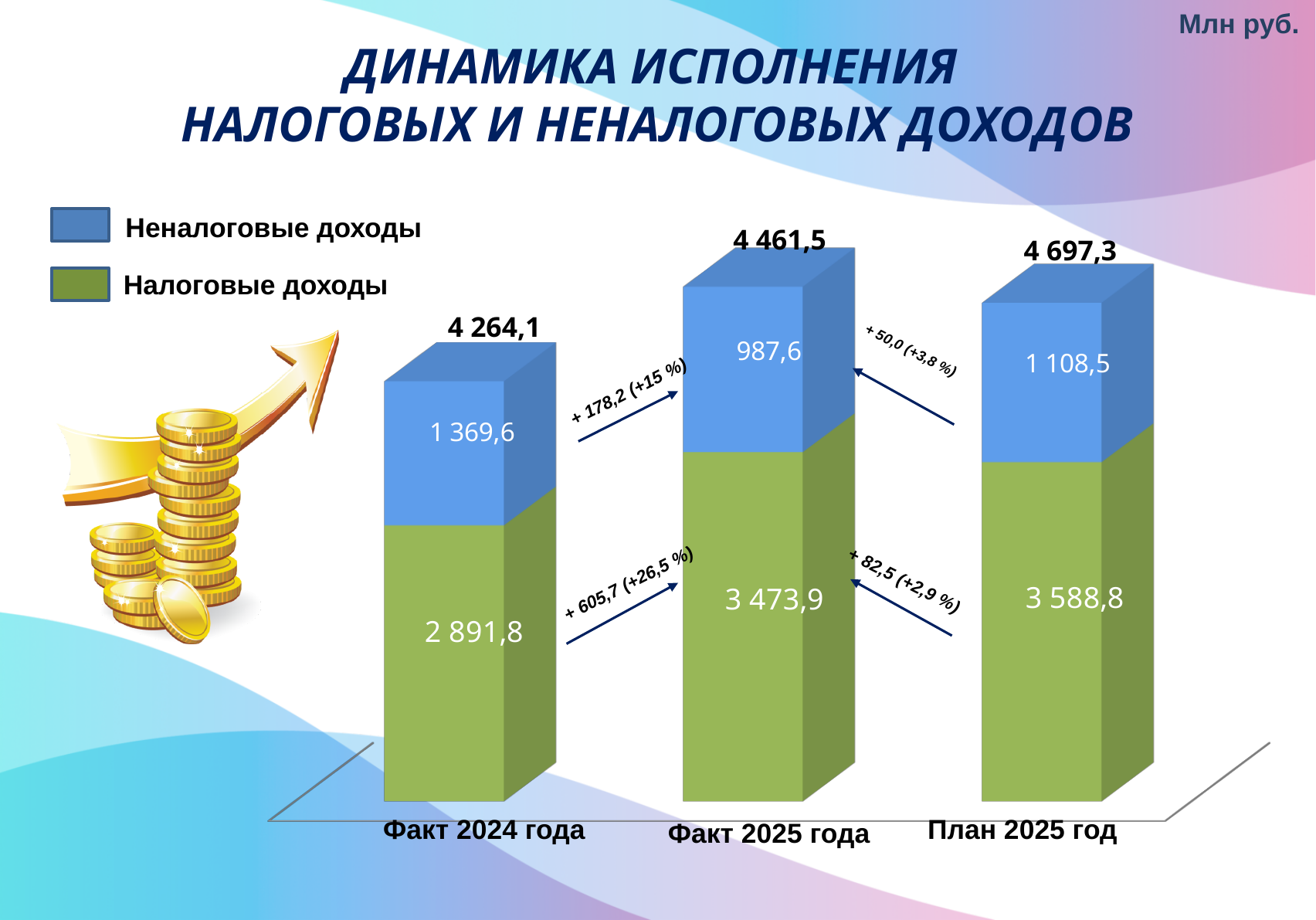
What kind of chart is shown on the slide? Stacked bar chart What is the total shown above the bar for Факт 2025 года? 4 461,5 Which category has the lowest value for Неналоговые доходы? Факт 2025 года What is the difference between Налоговые доходы for План 2025 год and Факт 2025 года? 114,9 Which is larger: Неналоговые доходы for Факт 2024 года or for План 2025 год? Факт 2024 года What is the value of Неналоговые доходы for План 2025 год? 1 108,5 How many categories are shown on the x axis? 3 Which category has the highest total? План 2025 год What is the value of Налоговые доходы for Факт 2024 года? 2 891,8 How many series does the legend list? 2 What is the value of Неналоговые доходы for Факт 2025 года? 987,6 Which colour represents Налоговые доходы in the legend? Green